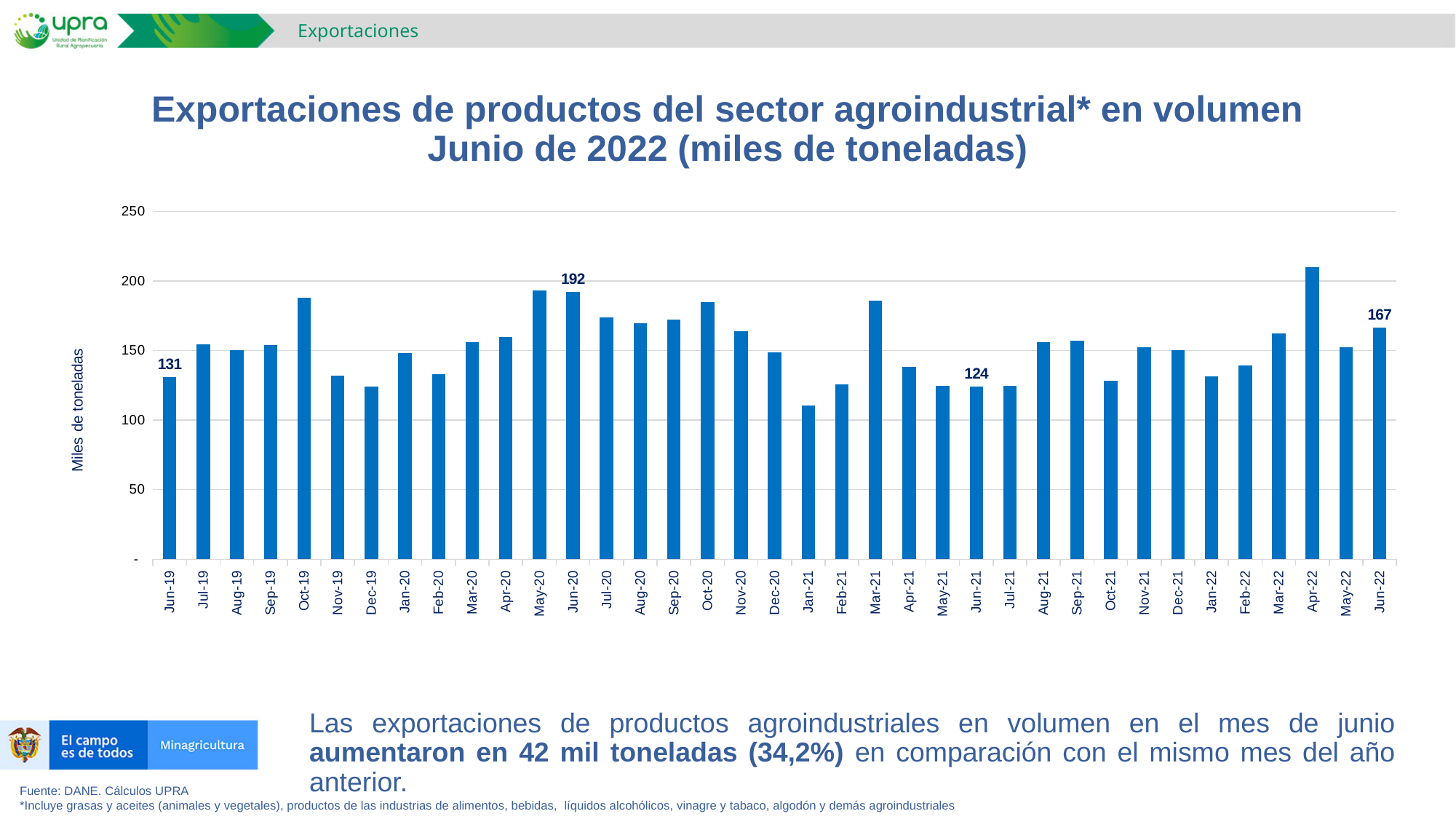
What kind of chart is shown on the slide? bar chart What is the value for Jun-21? 124 Is the value for Jan-21 greater or less than 150? less Which is larger, the value for Jun-20 or the value for Jun-22? Jun-20 What is the value for Jun-22? 167 Is the value for Apr-22 greater or less than 200? greater How many monthly bars are plotted in the chart? 37 What is the value for Jun-19? 131 What is the value for Jun-20? 192 What is the difference between the values for Jun-20 and Jun-19? 61 Which month has the lowest bar? Jan-21 Which month has the highest bar? Apr-22